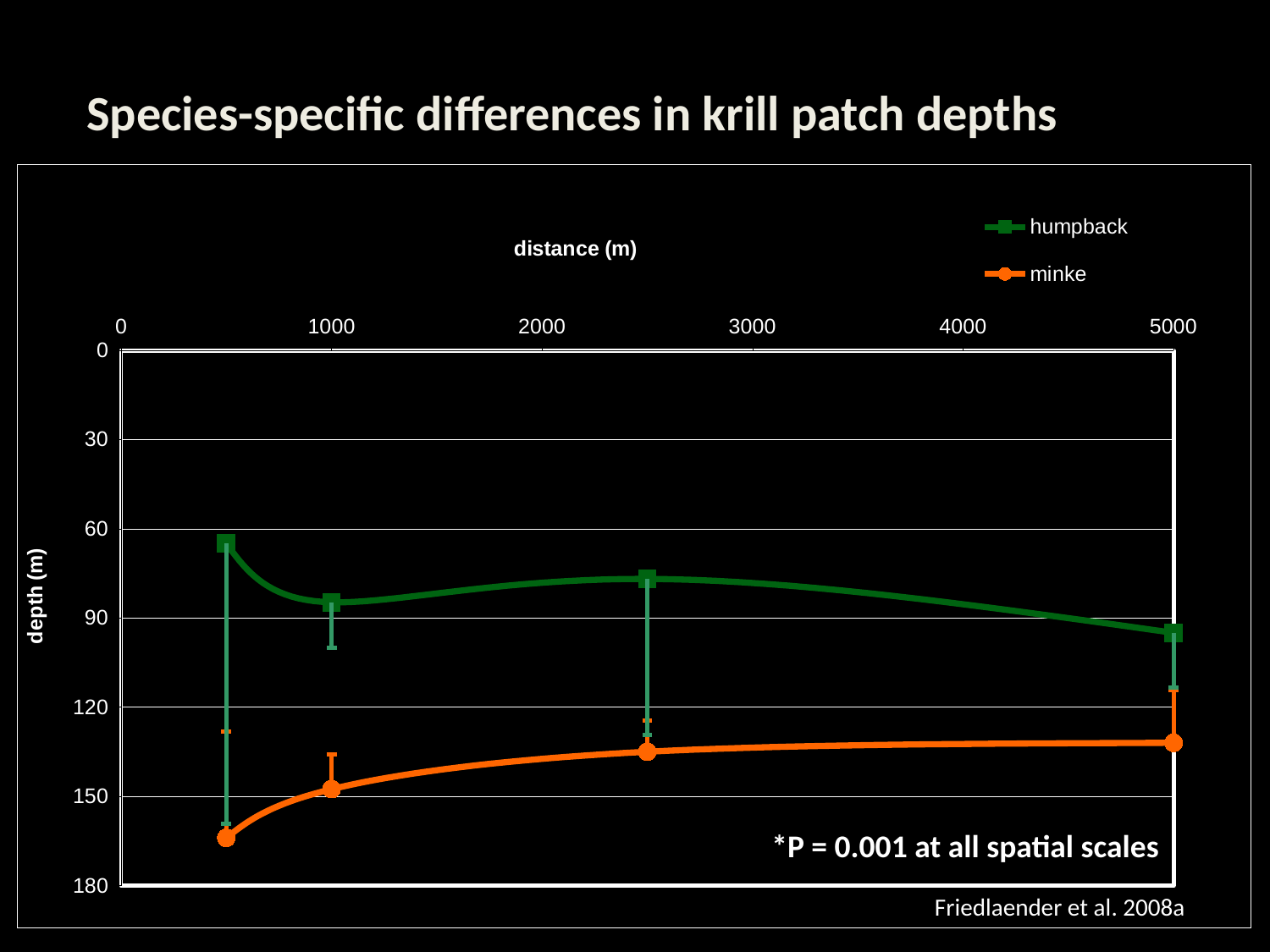
At 500 m distance, which series has the larger depth value, humpback or minke? minke At which distance does the minke series have its highest depth value? 500 Is the minke depth value at 500 m distance greater or less than 150? greater At which distance does the humpback series have its lowest depth value? 500 How many series does the legend list? 2 What kind of chart is shown on the slide? line chart Is the humpback depth value at 2500 m distance greater or less than 90? less Is the minke depth value at 5000 m distance greater or less than 120? greater How many data points are plotted for the minke series? 4 What is the title of the x axis? distance (m)